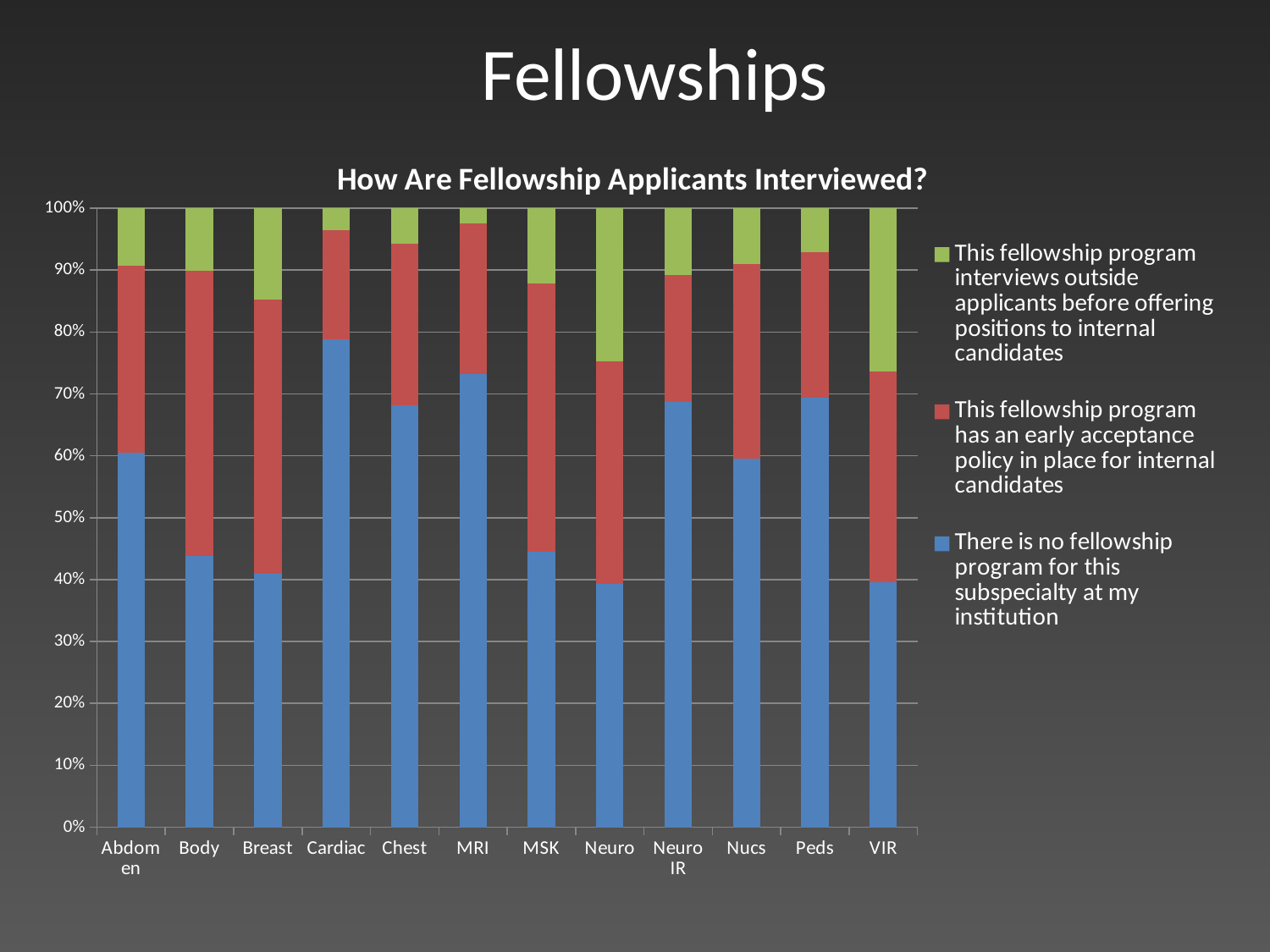
Which has a larger 'There is no fellowship program for this subspecialty at my institution' share, Abdomen or Breast? Abdomen Is the 'There is no fellowship program for this subspecialty at my institution' share for Chest greater or less than 60%? greater Is the 'There is no fellowship program for this subspecialty at my institution' share for Neuro greater or less than 50%? less Which has a larger 'There is no fellowship program for this subspecialty at my institution' share, Cardiac or Body? Cardiac Which category has the largest share for 'There is no fellowship program for this subspecialty at my institution'? Cardiac Is the 'There is no fellowship program for this subspecialty at my institution' share for Cardiac greater or less than 70%? greater Which legend entry is shown in blue? There is no fellowship program for this subspecialty at my institution What kind of chart is shown on the slide? Stacked bar chart How many series does the chart's legend list? 3 What is the title of the chart? How Are Fellowship Applicants Interviewed? How many subspecialty categories are shown on the x axis of the chart? 12 What is the total height of the stacked bar for Body? 100%